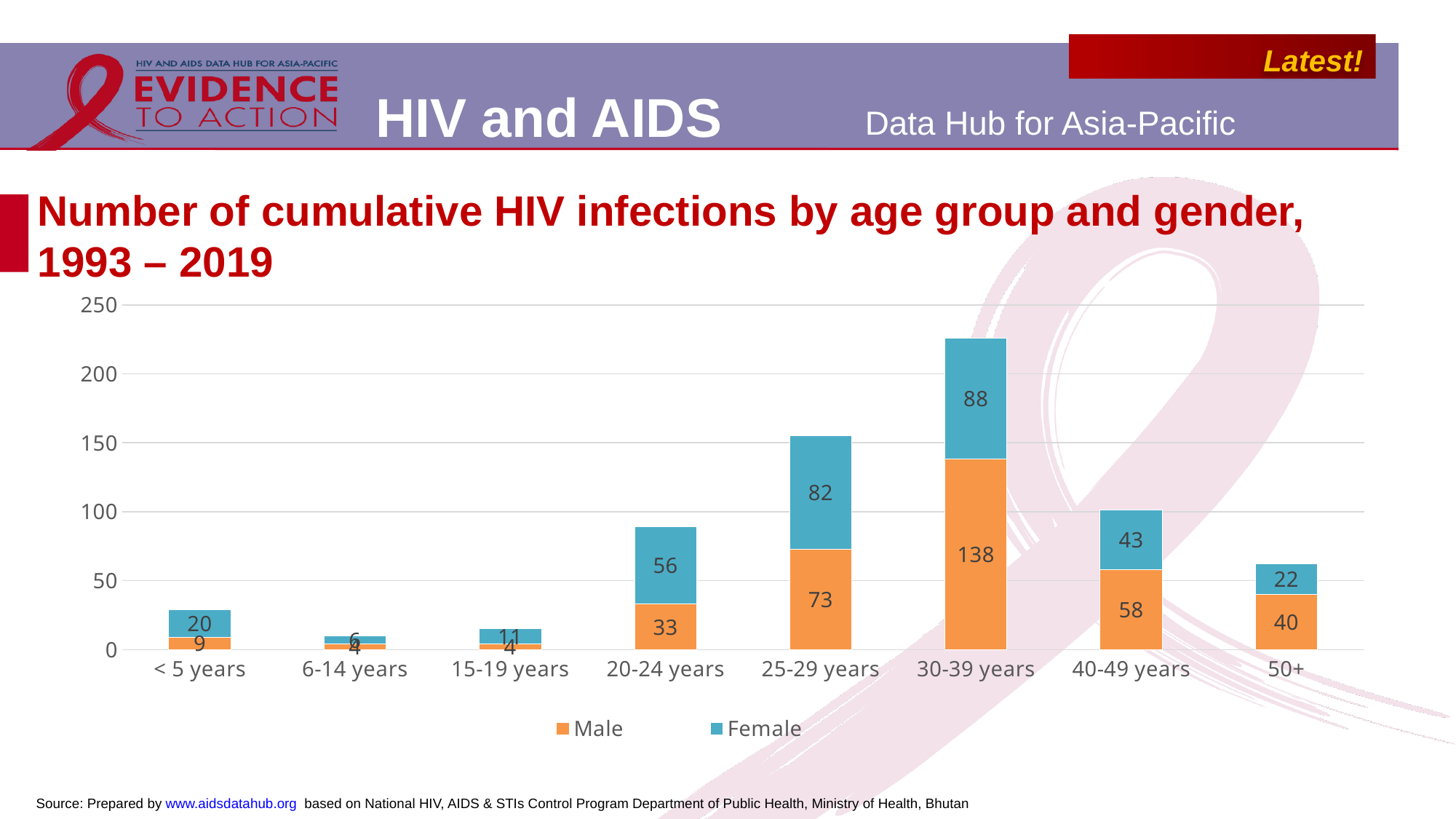
Which age group has the highest Male value? 30-39 years Which age group has the highest Female value? 30-39 years How many age groups are shown on the x axis? 8 What is the Female value for the 25-29 years age group? 82 What is the total of the stacked bar for the 30-39 years age group? 226 What is the Male value for the 30-39 years age group? 138 What is the difference between the Male and Female values for the 40-49 years age group? 15 Which is larger for the 25-29 years age group, the Male value or the Female value? Female What is the Female value for the 50+ age group? 22 What is the Male value for the 20-24 years age group? 33 How many series does the legend list? 2 What kind of chart is shown on the slide? Stacked bar chart